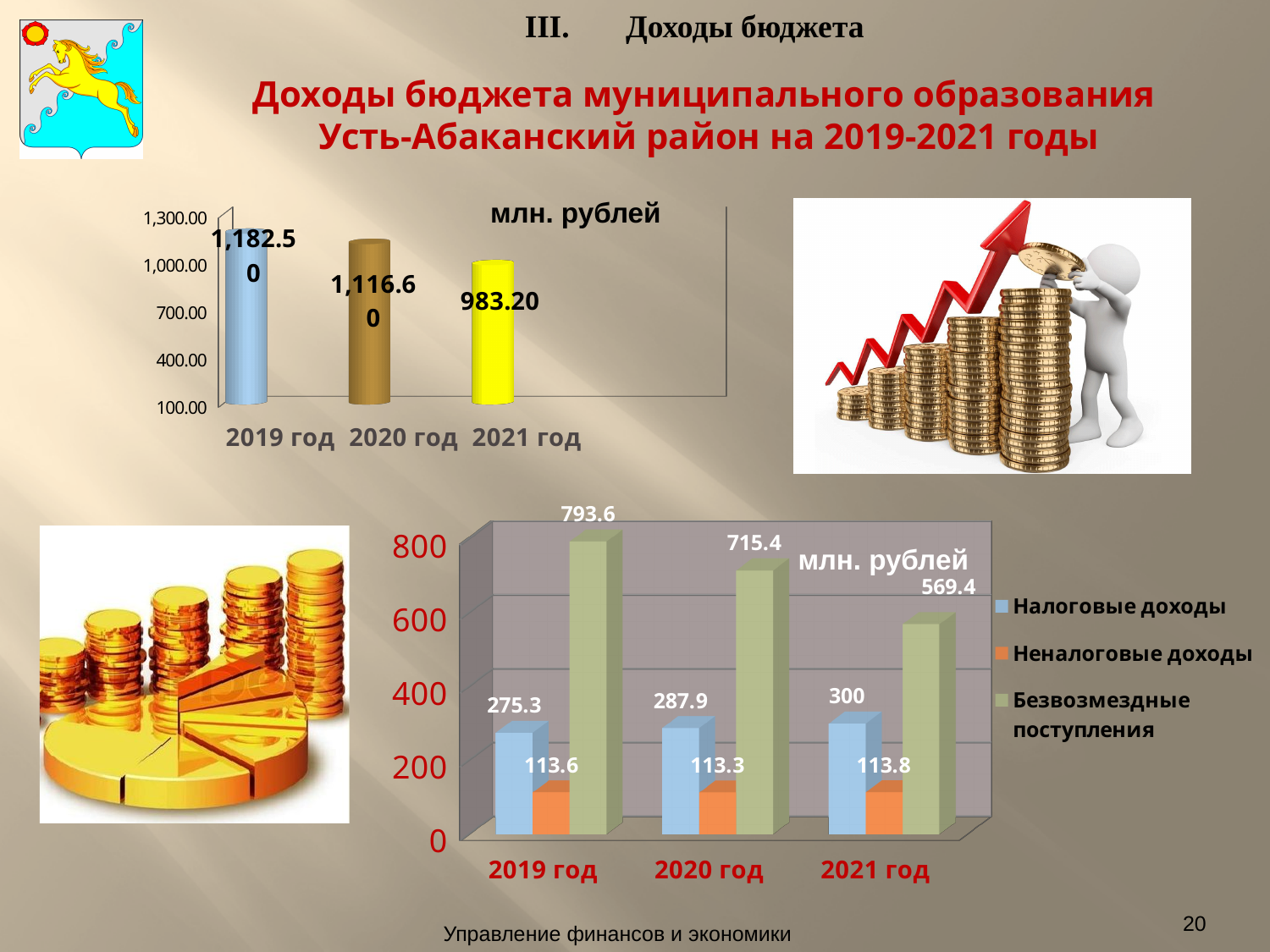
In the bottom chart, what is the value of Неналоговые доходы for 2019 год? 113.6 In the bottom chart, what is the difference between Безвозмездные поступления in 2019 год and 2021 год? 224.2 In the bottom chart, what is the value of Налоговые доходы for 2021 год? 300 In the top-left chart, what is the value for 2021 год? 983.20 In the bottom chart, which is larger for 2020 год: Налоговые доходы or Неналоговые доходы? Налоговые доходы In the top-left chart, do the values rise or fall from 2019 год to 2021 год? fall In the bottom chart, what is the value of Безвозмездные поступления for 2020 год? 715.4 What kind of chart is the bottom chart? bar chart In the top-left chart, how many years are plotted? 3 In the top-left chart, which year has the lowest value? 2021 год In the bottom chart, how many series does the legend list? 3 In the top-left chart, what is the value for 2019 год? 1,182.50